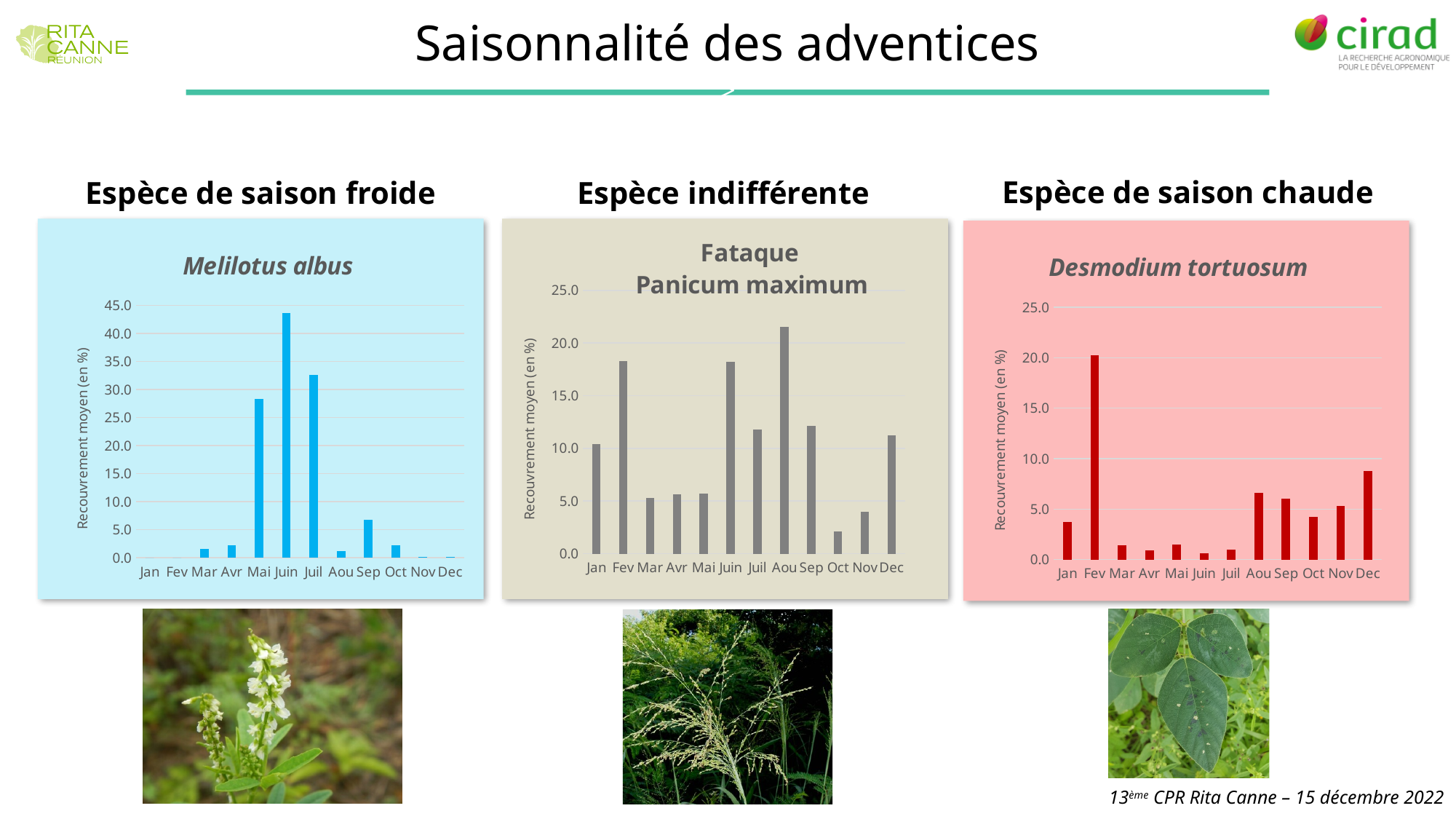
In the Desmodium tortuosum chart, which is larger, the value for Aou or the value for Dec? Dec What kind of chart is the Melilotus albus chart? bar chart In the Melilotus albus chart, which is larger, the value for Mai or the value for Juil? Juil In the Desmodium tortuosum chart, is the value for Dec greater or less than 10.0? less In the Melilotus albus chart, is the value for Juin greater or less than 40.0? greater How many months are shown on the x axis of the Melilotus albus chart? 12 In the Fataque Panicum maximum chart, is the value for Aou greater or less than 20.0? greater In the Melilotus albus chart, which month has the highest value? Juin What is the y-axis label of the Desmodium tortuosum chart? Recouvrement moyen (en %) In the Fataque Panicum maximum chart, which month has the highest value? Aou In the Desmodium tortuosum chart, which month has the highest value? Fev In the Fataque Panicum maximum chart, which month has the lowest value? Oct